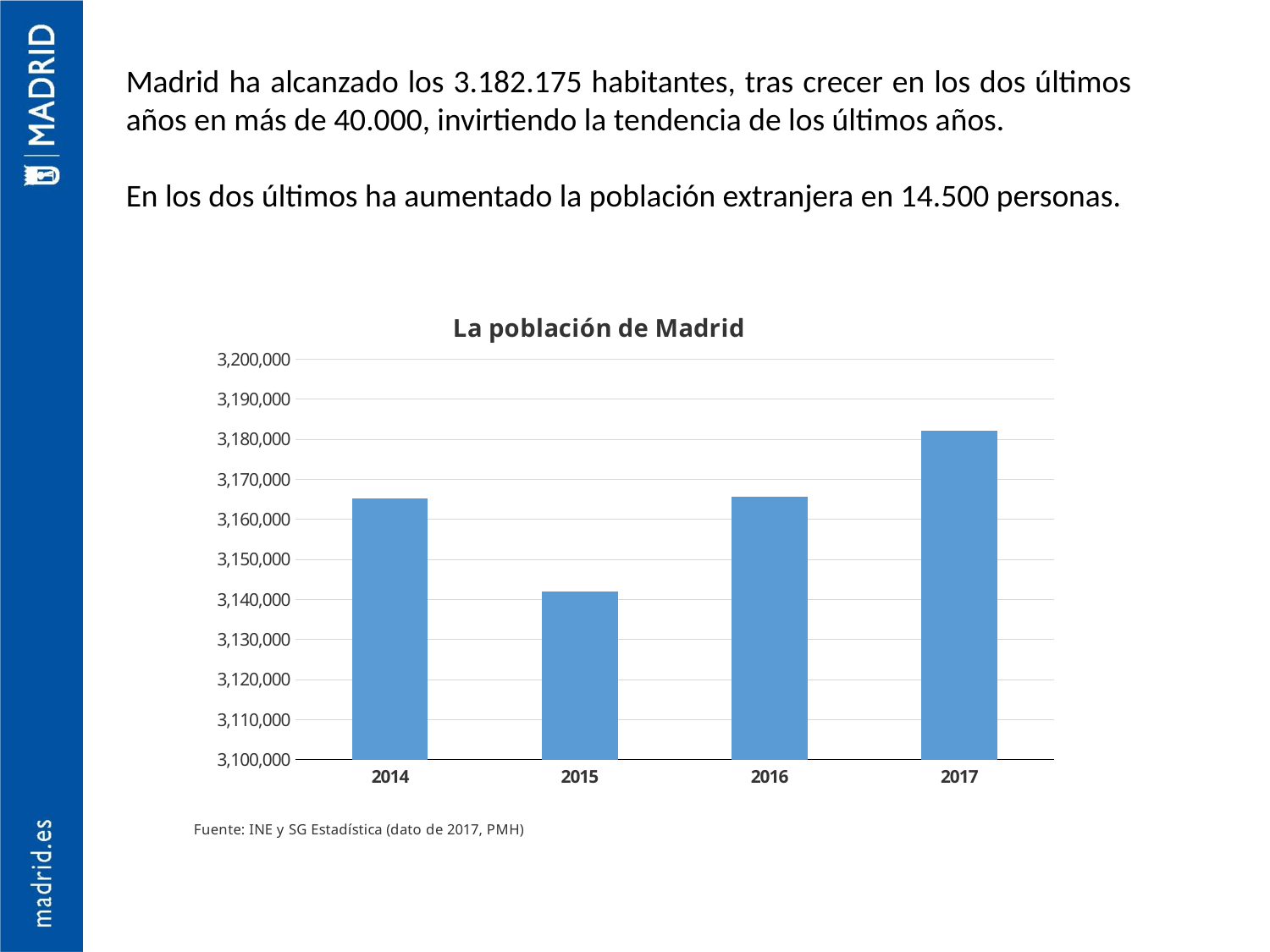
Is the value for 2014 greater or less than 3,160,000? greater Which year has the highest population in the chart? 2017 Is the value for 2016 greater or less than 3,170,000? less What colour are the bars in the chart? blue What kind of chart is shown on the slide? bar chart How many years are shown on the x axis of the chart? 4 Which year has the lowest population in the chart? 2015 What is the title of the chart? La población de Madrid Which year has the larger population, 2015 or 2017? 2017 Is the value for 2017 greater or less than 3,170,000? greater Do the values rise or fall from 2015 to 2017? rise